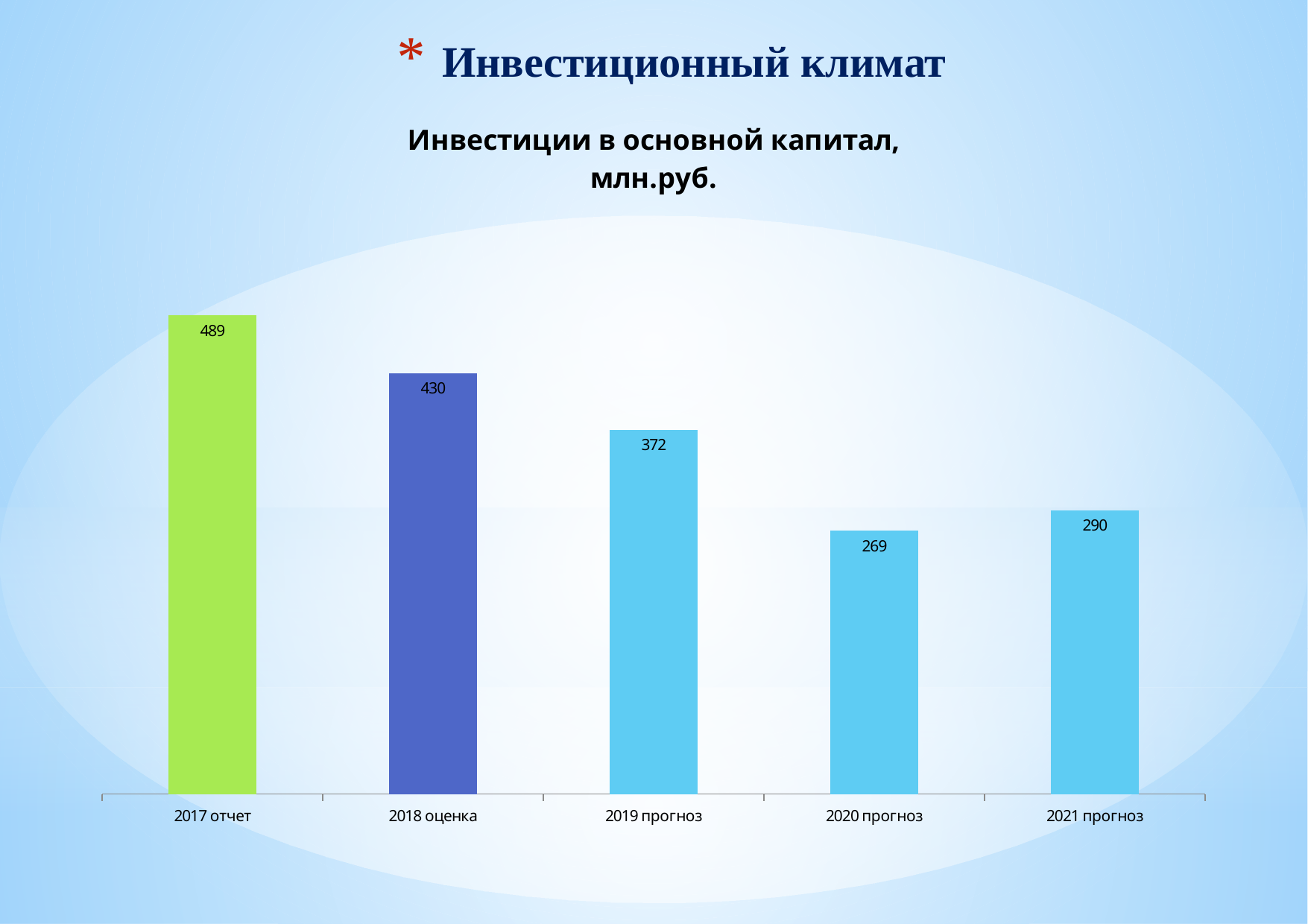
What is the title of the chart? Инвестиции в основной капитал, млн.руб. What kind of chart is shown on the slide? bar chart Do the values rise or fall from 2017 отчет to 2020 прогноз? fall Which is larger, the value for 2019 прогноз or the value for 2021 прогноз? 2019 прогноз Which category has the highest value? 2017 отчет What is the value for 2017 отчет? 489 What is the difference between the values for 2017 отчет and 2018 оценка? 59 What is the value for 2021 прогноз? 290 Which category has the lowest value? 2020 прогноз What is the value for 2019 прогноз? 372 What is the difference between the values for 2021 прогноз and 2020 прогноз? 21 How many categories are shown on the x axis? 5